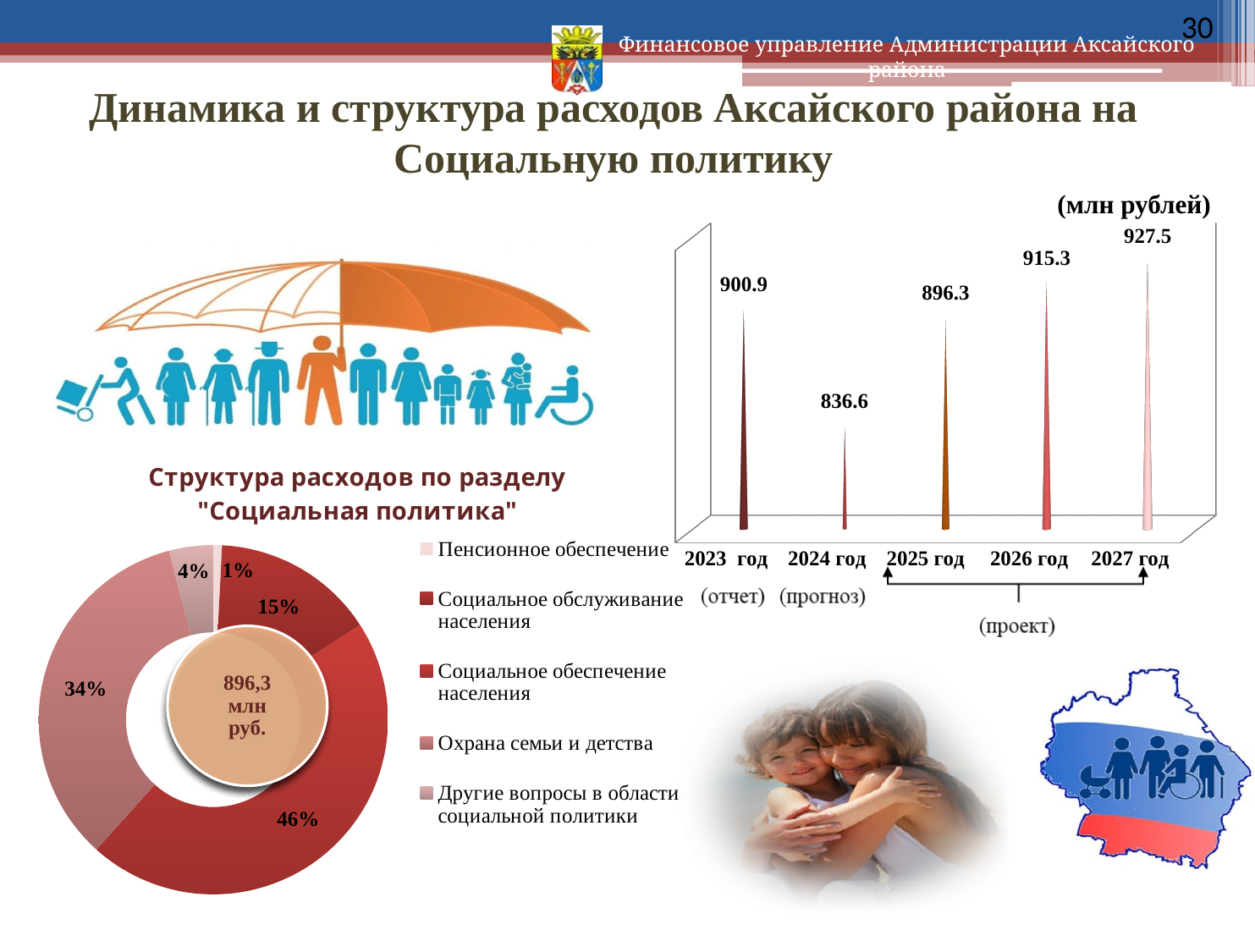
On the pie chart "Структура расходов по разделу "Социальная политика"", what share is Социальное обеспечение населения? 46% On the bar chart on the right, which year has the highest value? 2027 год What kind of chart is the chart on the right showing values by year? bar chart On the bar chart on the right, what is the difference between the values for 2027 год and 2023 год? 26.6 On the bar chart on the right, which is larger: the value for 2023 год or the value for 2025 год? 2023 год On the bar chart on the right, what is the value for 2027 год? 927.5 On the pie chart "Структура расходов по разделу "Социальная политика"", which category has the smallest share? Пенсионное обеспечение On the bar chart on the right, which year has the lowest value? 2024 год On the bar chart on the right, do the values rise or fall from 2024 год to 2027 год? rise On the bar chart on the right, how many years are shown? 5 How many entries does the legend of the pie chart "Структура расходов по разделу "Социальная политика"" list? 5 On the bar chart on the right, what is the value for 2024 год? 836.6